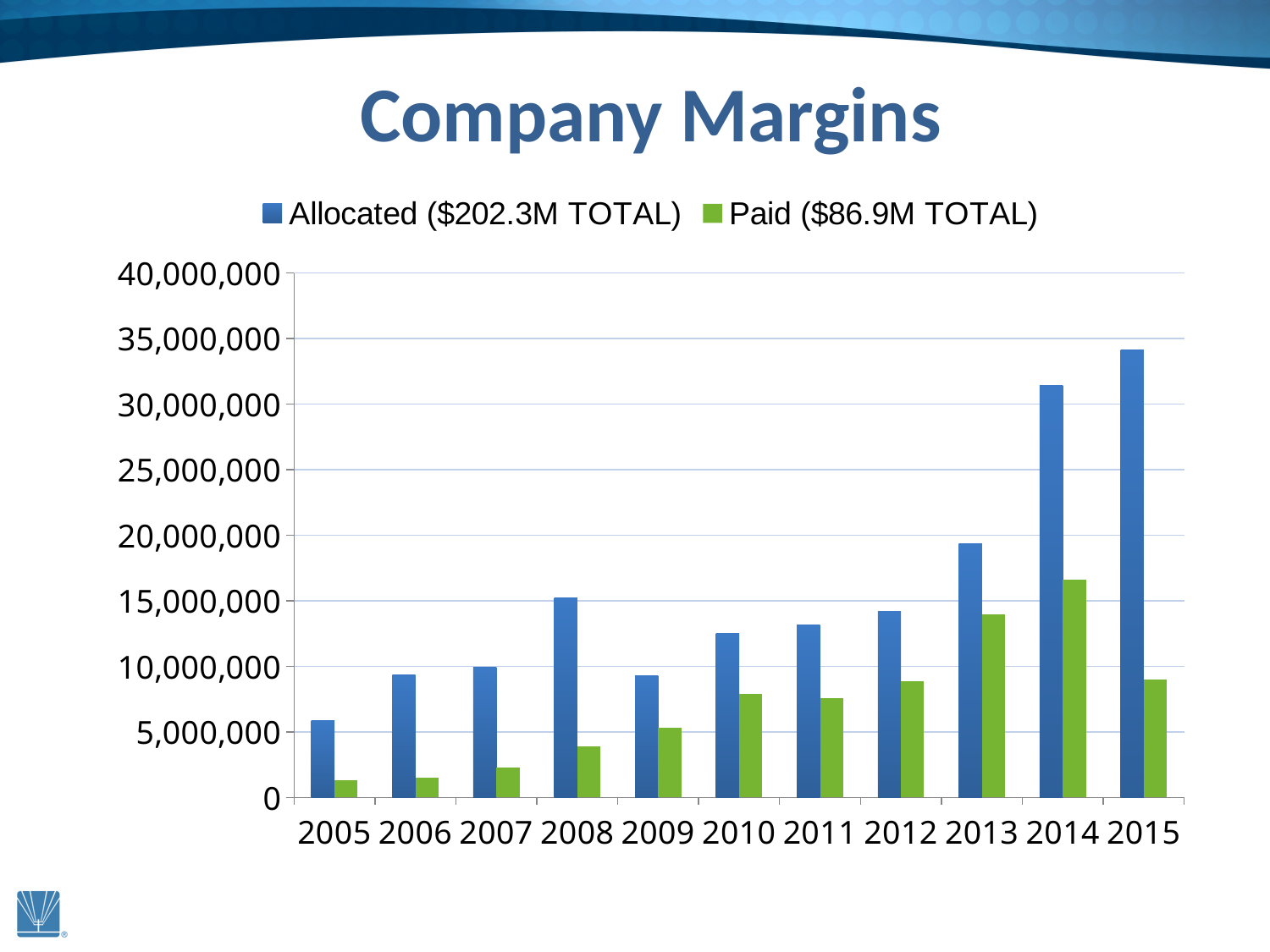
Which year has the highest Paid value? 2014 How many years are shown on the x axis? 11 What total is shown in the legend for the Paid series? $86.9M TOTAL Do the Allocated values rise or fall from 2012 to 2015? Rise Which year has the highest Allocated value? 2015 Which year has the lowest Paid value? 2005 How many series does the legend list? 2 Which is larger, the Allocated value for 2008 or for 2009? 2008 Is the Allocated value for 2014 greater or less than 30,000,000? greater Which year has the lowest Allocated value? 2005 What kind of chart is shown on the slide? Bar chart Is the Paid value for 2013 greater or less than 15,000,000? less